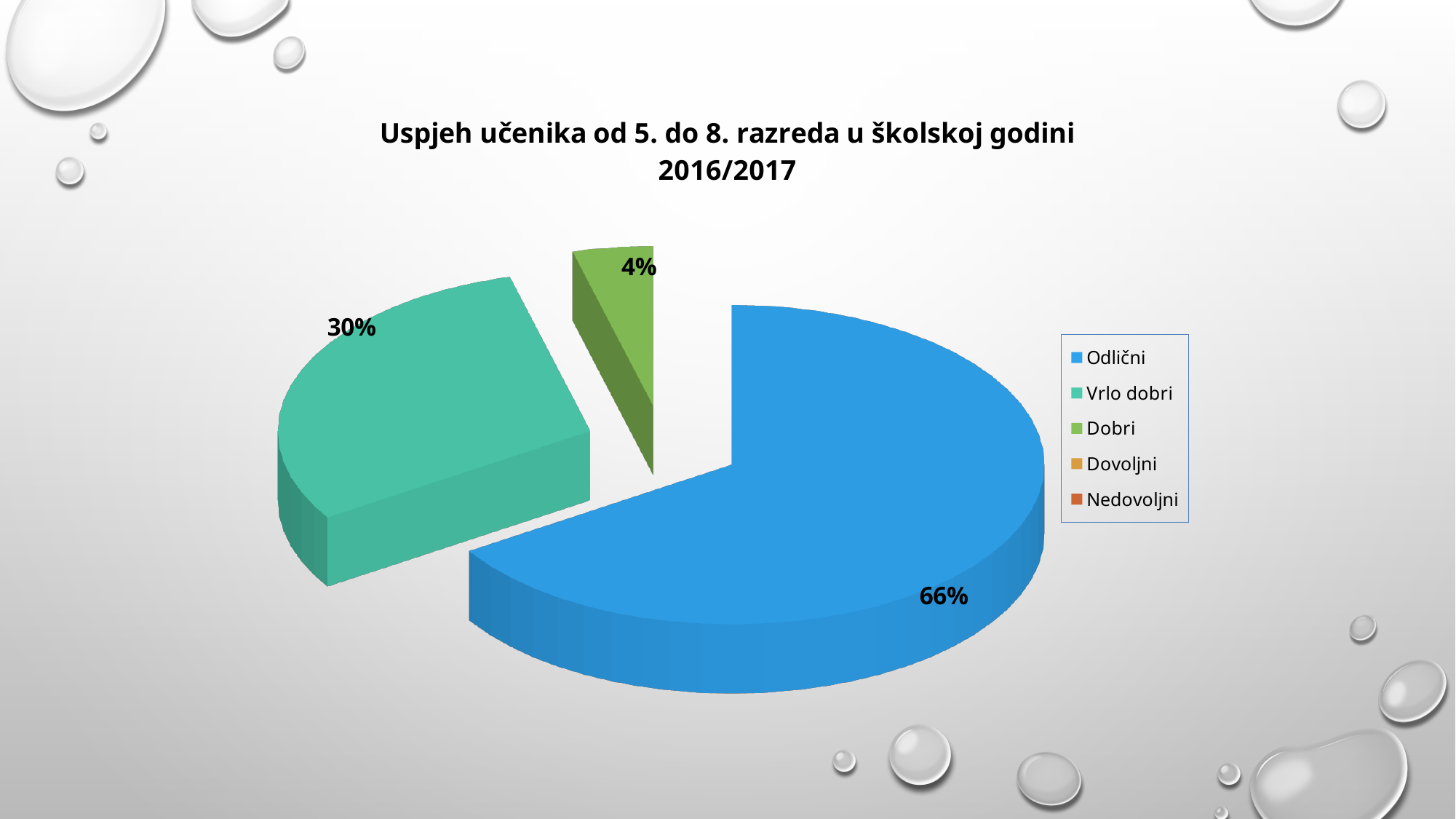
Which of the labelled slices is the smallest? Dobri Which category has the largest slice of the pie? Odlični Which is larger, the share for Vrlo dobri or the share for Dobri? Vrlo dobri What share of the pie is labelled for Odlični? 66% What is the title of the chart? Uspjeh učenika od 5. do 8. razreda u školskoj godini 2016/2017 How many slices with percentage labels are visible in the pie? 3 How many entries does the legend list? 5 What share of the pie is labelled for Dobri? 4% What kind of chart is shown on the slide? Pie chart What share of the pie is labelled for Vrlo dobri? 30% What is the difference between the Odlični share and the Vrlo dobri share? 36% What colour is the Odlični slice? Blue